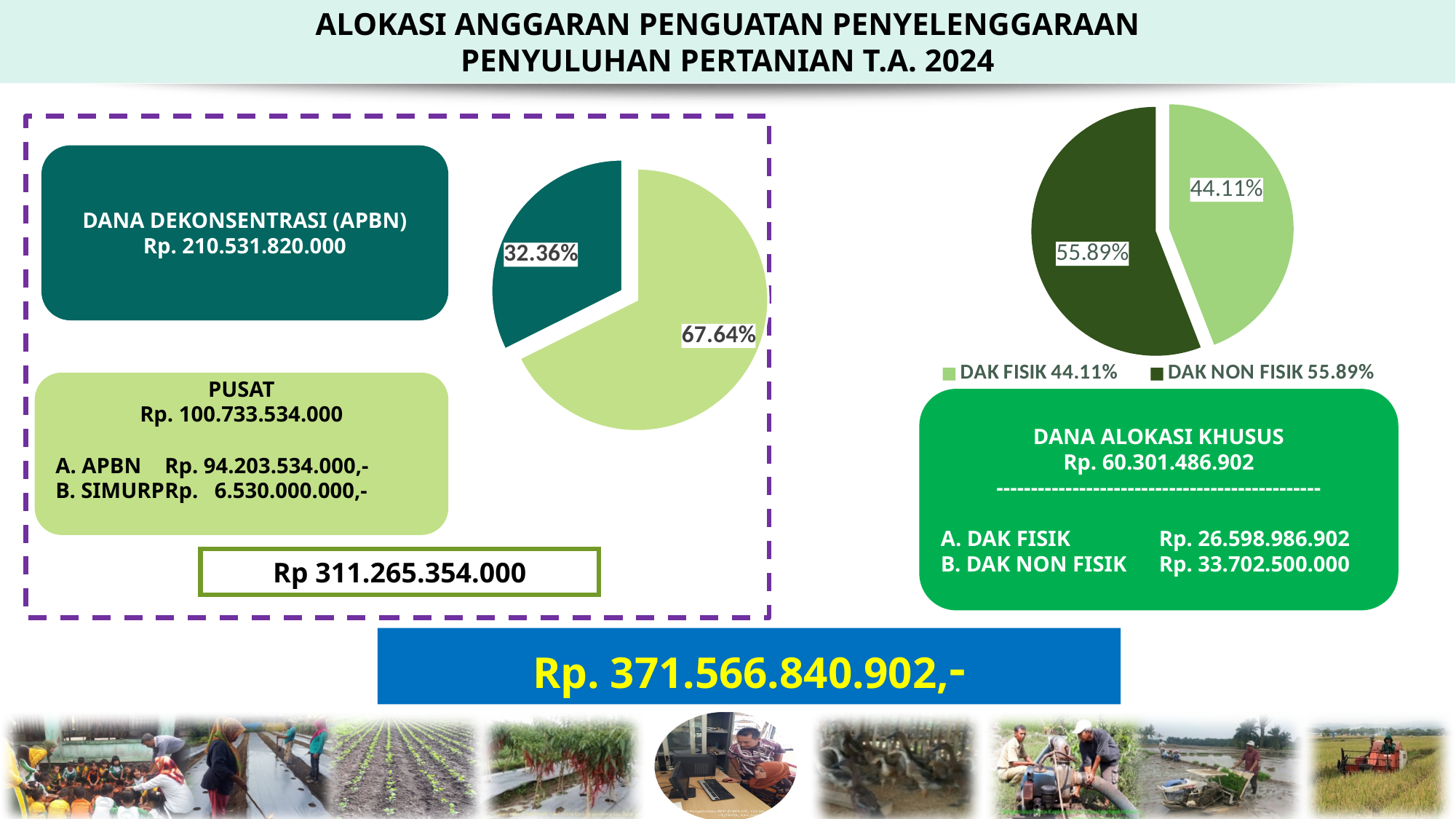
In the pie chart on the left, what percentage is labelled on the larger light green slice? 67.64% In the pie chart on the right, what share is shown for DAK FISIK? 44.11% How many entries does the legend of the pie chart on the right list? 2 What kind of chart is shown on the left side of the slide inside the dashed box? Pie chart In the pie chart on the left, is the share of the dark teal slice greater or less than 50%? less How many slices does the pie chart on the left have? 2 In the pie chart on the right, what share is shown for DAK NON FISIK? 55.89% In the pie chart on the left, what is the difference in percentage points between the two slices? 35.28 In the pie chart on the right, what colour is the DAK NON FISIK slice? Dark green In the pie chart on the right, what is the difference in percentage points between DAK NON FISIK and DAK FISIK? 11.78 In the pie chart on the right, which slice is larger, DAK FISIK or DAK NON FISIK? DAK NON FISIK